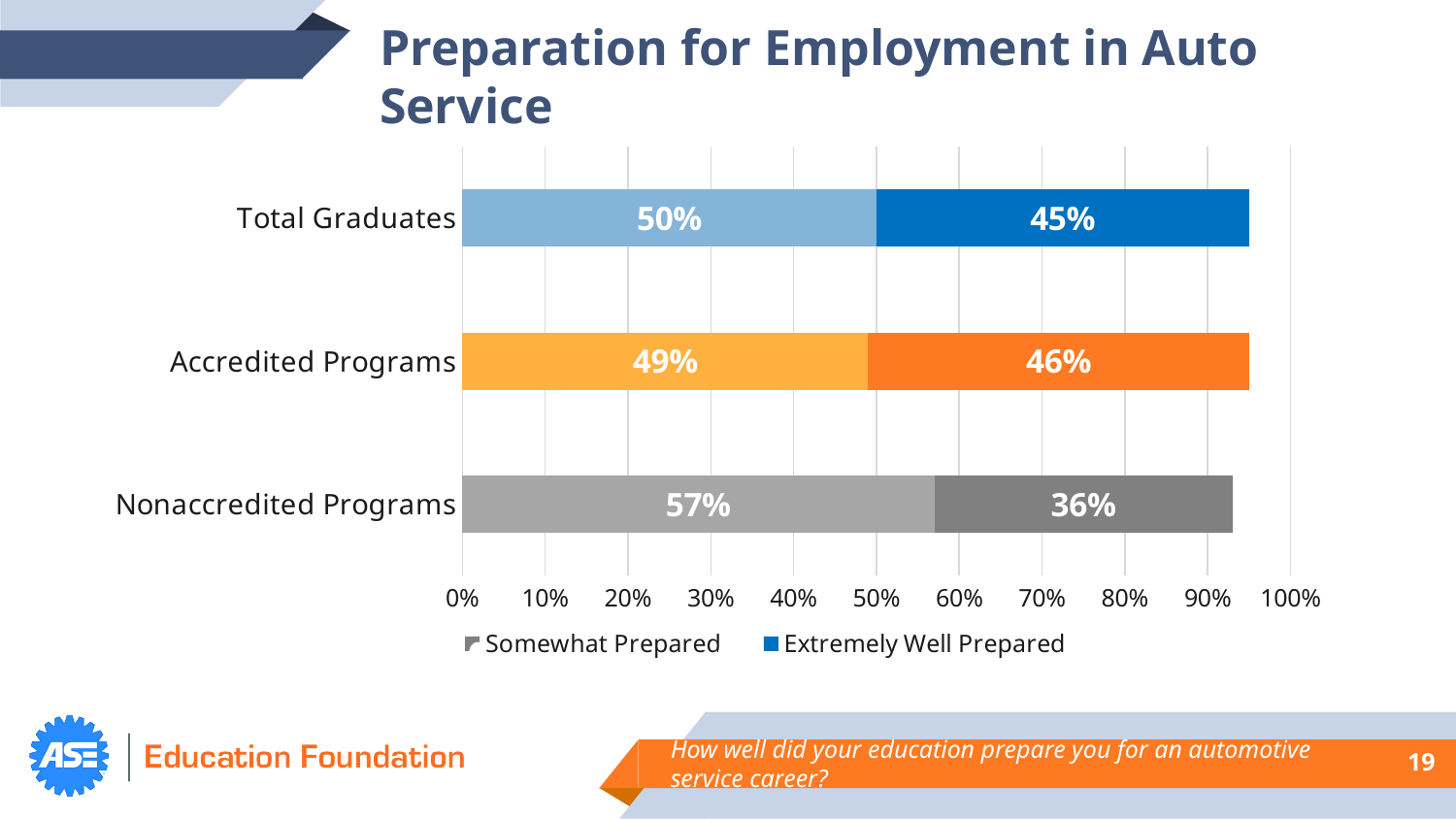
Which is larger: the Extremely Well Prepared value for Accredited Programs or for Nonaccredited Programs? Accredited Programs Which category has the highest Somewhat Prepared value? Nonaccredited Programs What is the total of the stacked bar for Nonaccredited Programs? 93% Which category has the lowest Extremely Well Prepared value? Nonaccredited Programs How many categories are shown on the chart? 3 What is the difference between the Somewhat Prepared and Extremely Well Prepared values for Nonaccredited Programs? 21% How many series does the legend list? 2 What percentage of Accredited Programs graduates were Extremely Well Prepared? 46% What is the total of the stacked bar for Total Graduates? 95% What percentage of Total Graduates were Somewhat Prepared? 50% What percentage of Nonaccredited Programs graduates were Somewhat Prepared? 57% What kind of chart is shown on the slide? Stacked bar chart